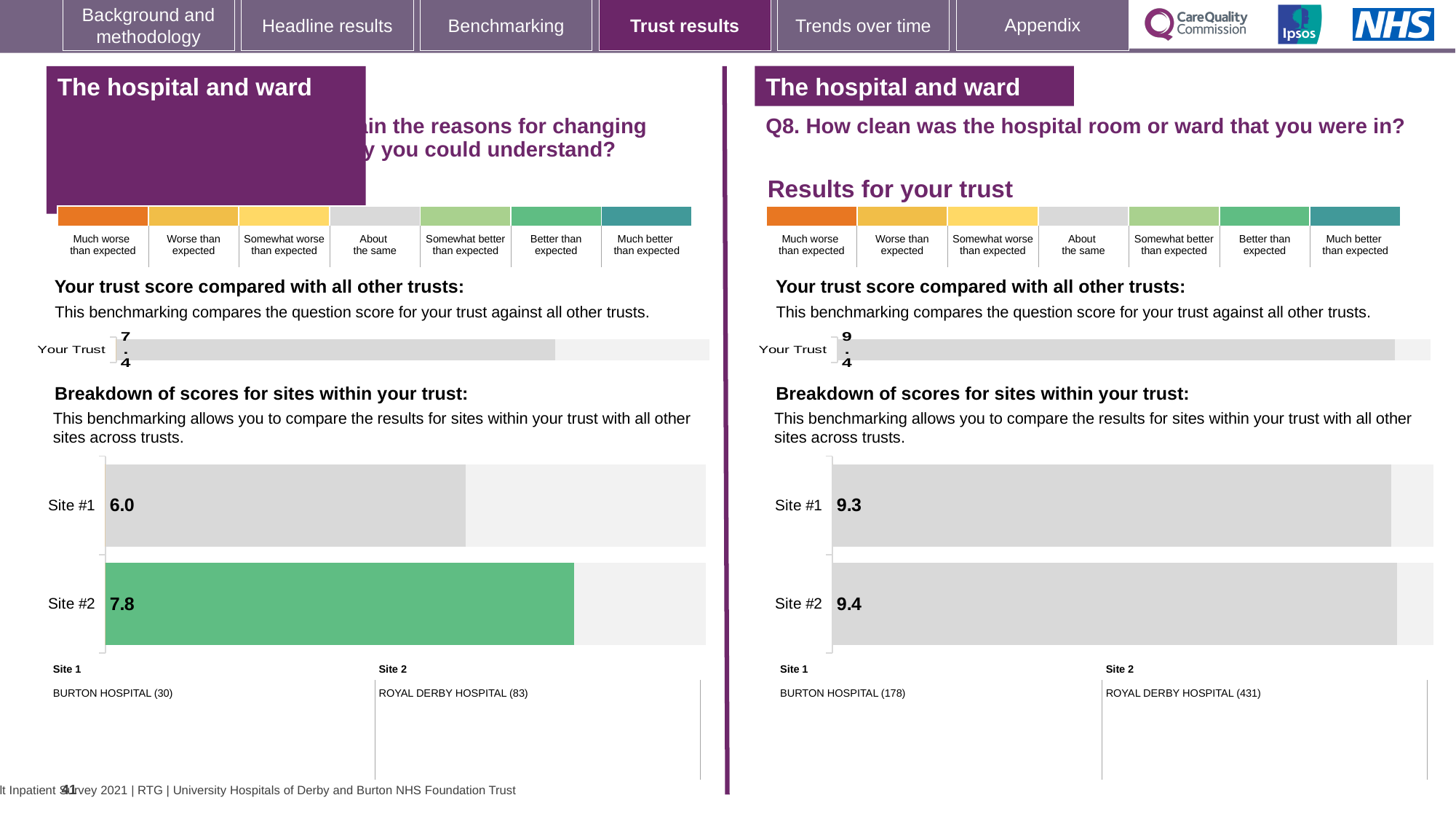
In the left-hand site breakdown chart, what is the score for Site #1? 6.0 In the right-hand (Q8) 'Your trust score compared with all other trusts' chart, what is the score for Your Trust? 9.4 In the left-hand site breakdown chart, what is the score for Site #2? 7.8 In the left-hand site breakdown chart, what is the difference between the Site #2 and Site #1 scores? 1.8 In the left-hand 'Your trust score compared with all other trusts' chart, what is the score for Your Trust? 7.4 In the right-hand (Q8) site breakdown chart, what is the score for Site #2? 9.4 How many sites are shown in the left-hand site breakdown chart? 2 In the left-hand site breakdown chart, which site has the higher score? Site #2 What kind of chart is the right-hand (Q8) site breakdown chart? Bar chart In the left-hand site breakdown chart, what colour is the bar for Site #2? Green In the right-hand (Q8) site breakdown chart, what is the difference between the Site #2 and Site #1 scores? 0.1 In the right-hand (Q8) site breakdown chart, what is the score for Site #1? 9.3